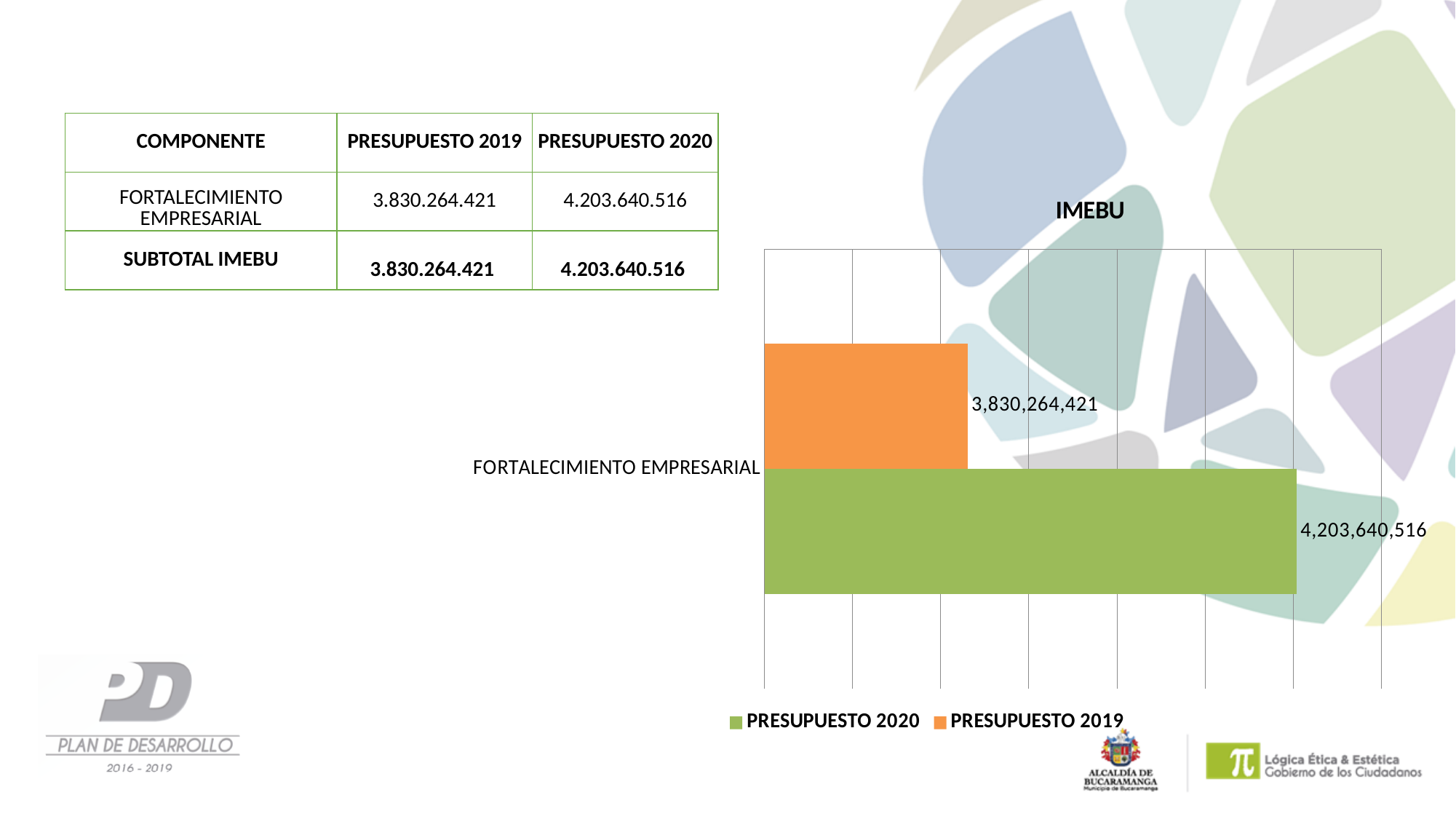
In the IMEBU chart, which colour represents PRESUPUESTO 2019? Orange What is the difference between the PRESUPUESTO 2020 and PRESUPUESTO 2019 values in the IMEBU chart? 373,376,095 How many series does the legend of the IMEBU chart list? 2 In the IMEBU chart, which series has the smaller value? PRESUPUESTO 2019 What is the value of PRESUPUESTO 2020 for FORTALECIMIENTO EMPRESARIAL in the IMEBU chart? 4,203,640,516 In the IMEBU chart, which series has the larger value: PRESUPUESTO 2019 or PRESUPUESTO 2020? PRESUPUESTO 2020 What is the value of PRESUPUESTO 2019 for FORTALECIMIENTO EMPRESARIAL in the IMEBU chart? 3,830,264,421 What kind of chart is the IMEBU chart? Bar chart What is the name of the category plotted in the IMEBU chart? FORTALECIMIENTO EMPRESARIAL How many categories are shown on the IMEBU chart? 1 What is the title of the chart on the slide? IMEBU